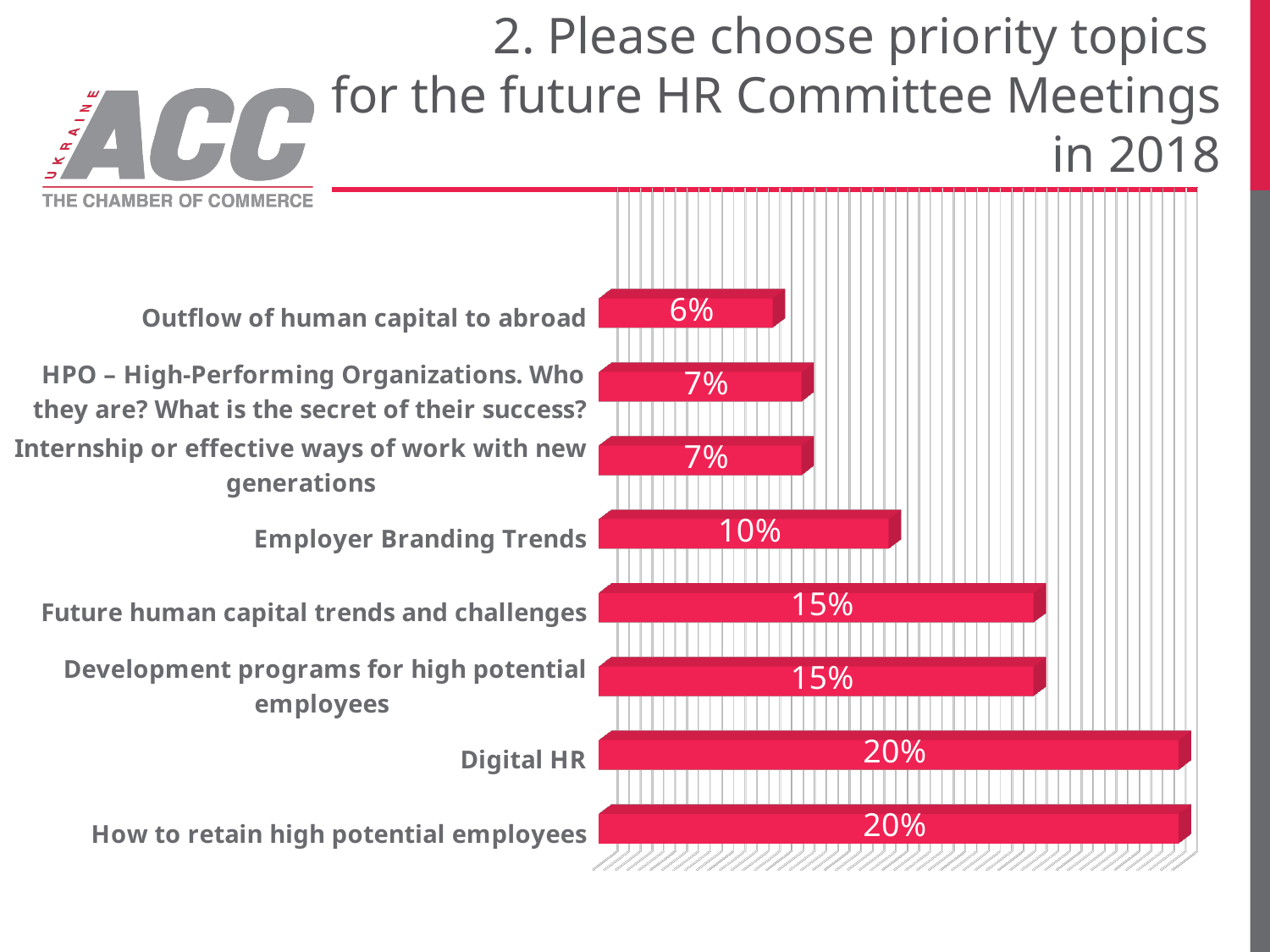
What is the difference between the value for Digital HR and the value for Outflow of human capital to abroad? 14% What is the difference between Employer Branding Trends and HPO – High-Performing Organizations? 3% What percentage is shown for Future human capital trends and challenges? 15% What is the highest value shown in the chart? 20% Which topic has the lowest value in the chart? Outflow of human capital to abroad What percentage of respondents chose Digital HR as a priority topic? 20% How many topics are shown in the chart? 8 What type of chart is shown on the slide? Bar chart Which has a larger value: Employer Branding Trends or Development programs for high potential employees? Development programs for high potential employees What is the value shown for Employer Branding Trends? 10% What is the value for Outflow of human capital to abroad? 6% What is the value for Internship or effective ways of work with new generations? 7%